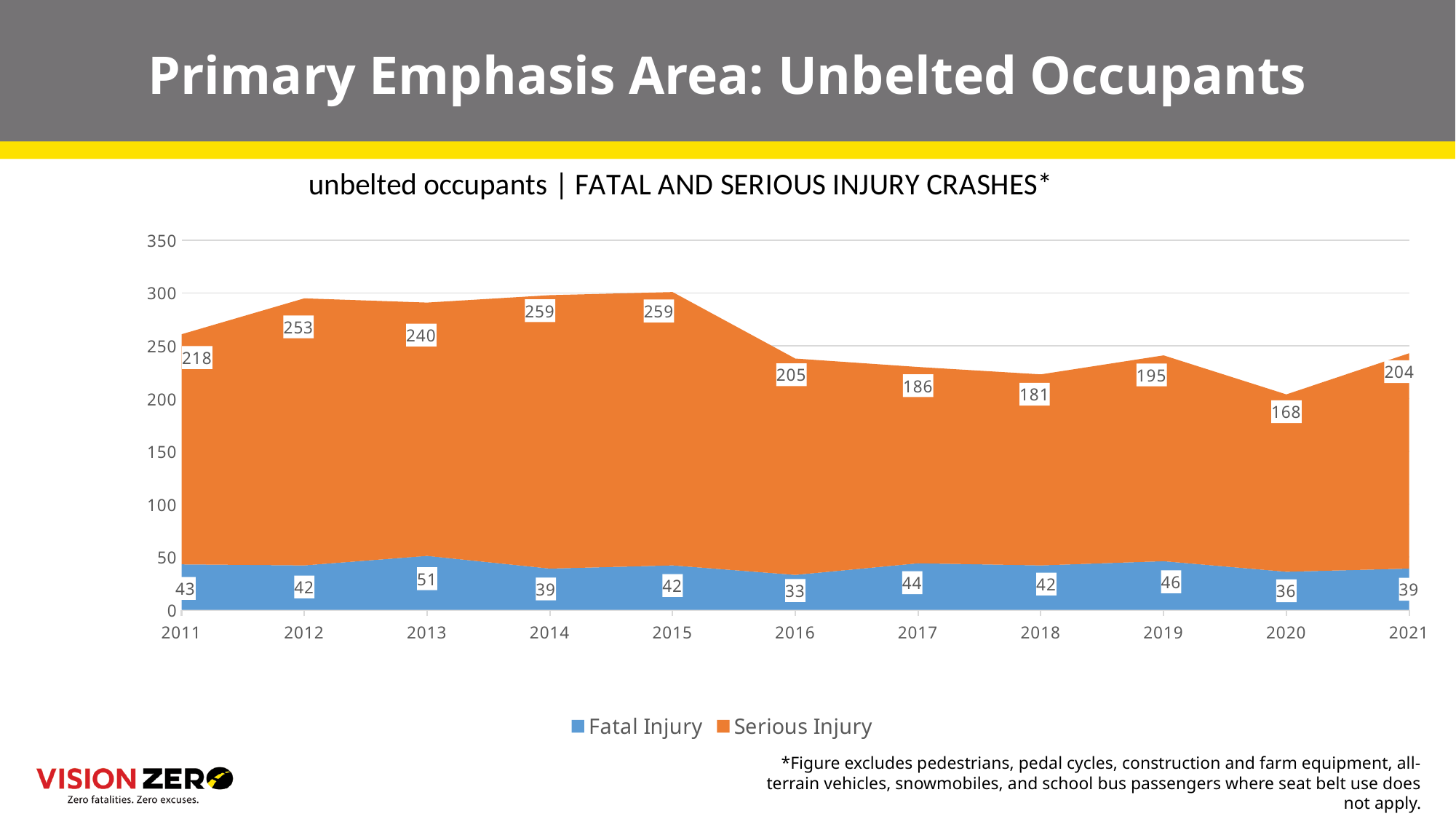
What kind of chart is shown on the slide? Stacked area chart What is the total of Fatal Injury and Serious Injury for 2011? 261 Which year has the lowest Fatal Injury value? 2016 Is the Serious Injury value larger in 2019 or in 2020? 2019 How many series does the legend list? 2 Which year has the lowest Serious Injury value? 2020 What is the Fatal Injury value for 2013? 51 What is the difference between the Serious Injury values for 2012 and 2013? 13 What is the Serious Injury value for 2016? 205 What is the Serious Injury value for 2021? 204 How many years are shown on the x axis? 11 Which year has the highest Fatal Injury value? 2013